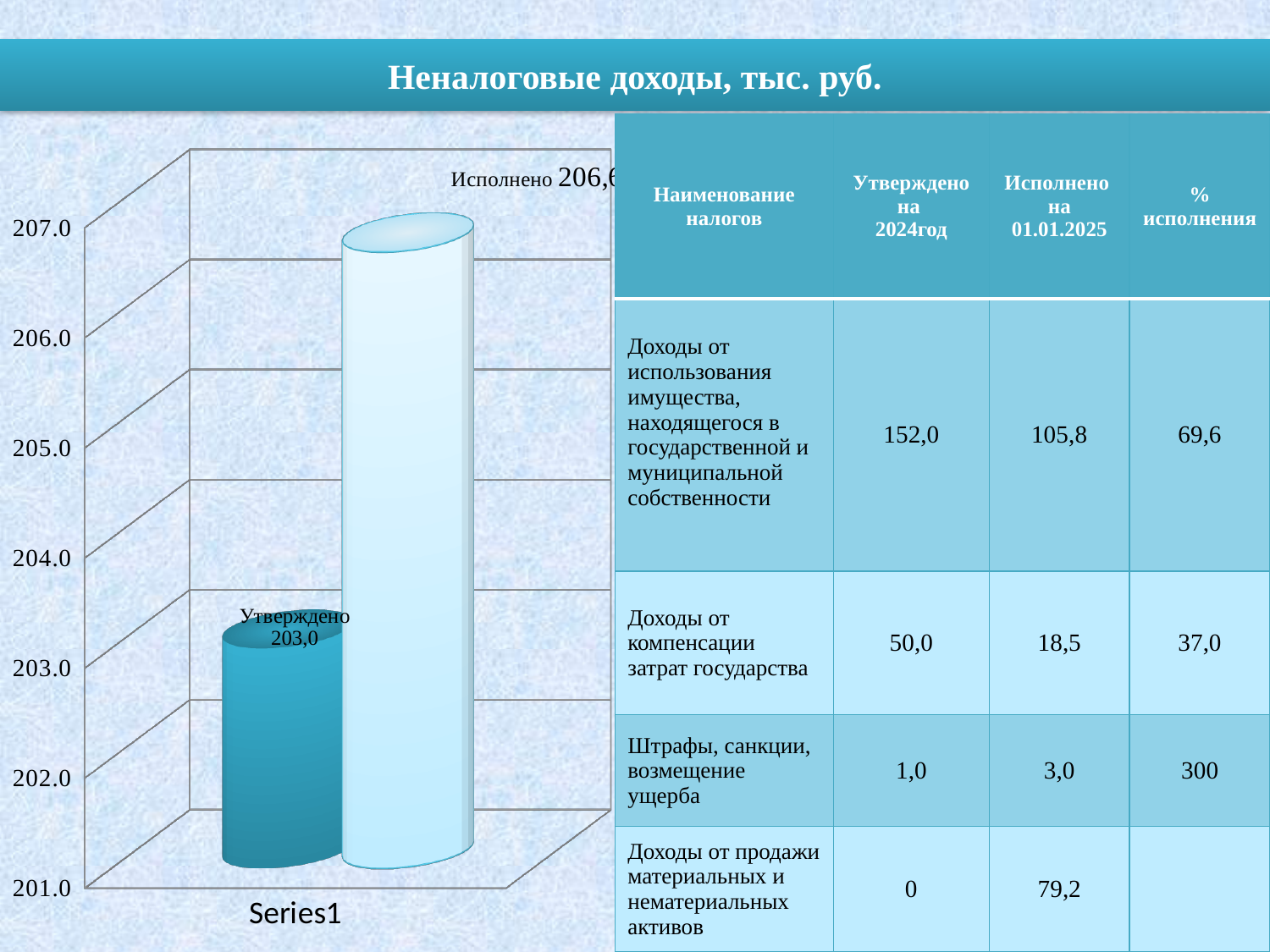
What is the title of the slide containing the chart? Неналоговые доходы, тыс. руб. What is the lowest value shown on the vertical axis of the chart? 201.0 What kind of chart is shown on the left of the slide? bar chart Which bar in the chart is the tallest? Исполнено What is the value of the Утверждено bar in the chart? 203,0 Which is larger in the chart, Исполнено or Утверждено? Исполнено What label appears under the bars on the horizontal axis of the chart? Series1 Is the value for Утверждено greater or less than 204.0? less How many bars are plotted in the chart? 2 Which bar in the chart is the shortest? Утверждено Is the value for Исполнено greater or less than 205.0? greater What is the highest value shown on the vertical axis of the chart? 207.0